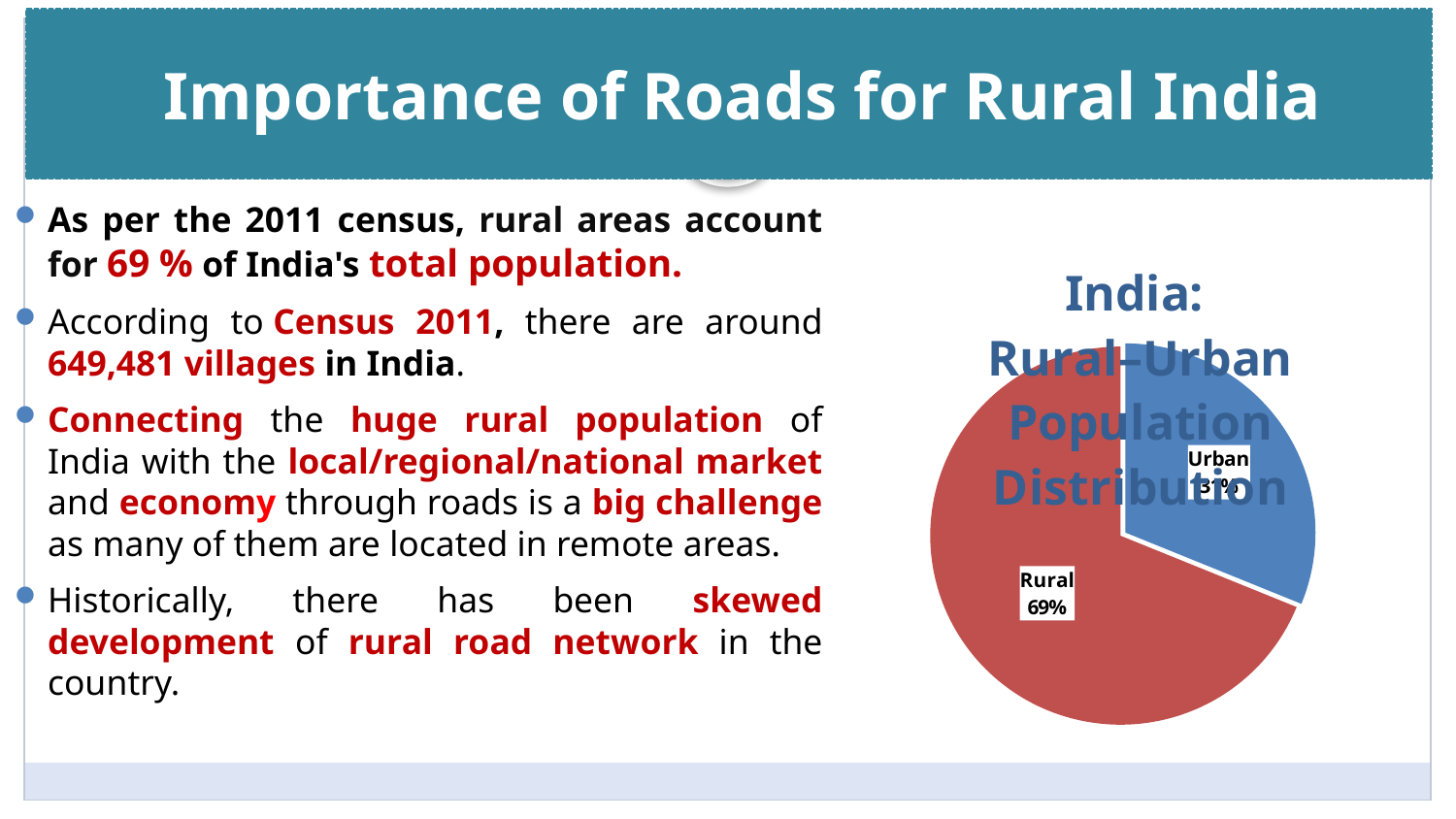
What is the difference in percentage points between the Rural and Urban slices? 38 How many slices does the pie chart have? 2 What share of the pie does Rural account for? 69% Which slice of the pie is the smallest? Urban Which is larger, the Rural slice or the Urban slice? Rural What share of the pie does Urban account for? 31% What kind of chart is shown on the slide? pie chart What colour is the Rural slice of the pie? red What is the title of the chart? India: Rural-Urban Population Distribution Which slice of the pie is the largest? Rural